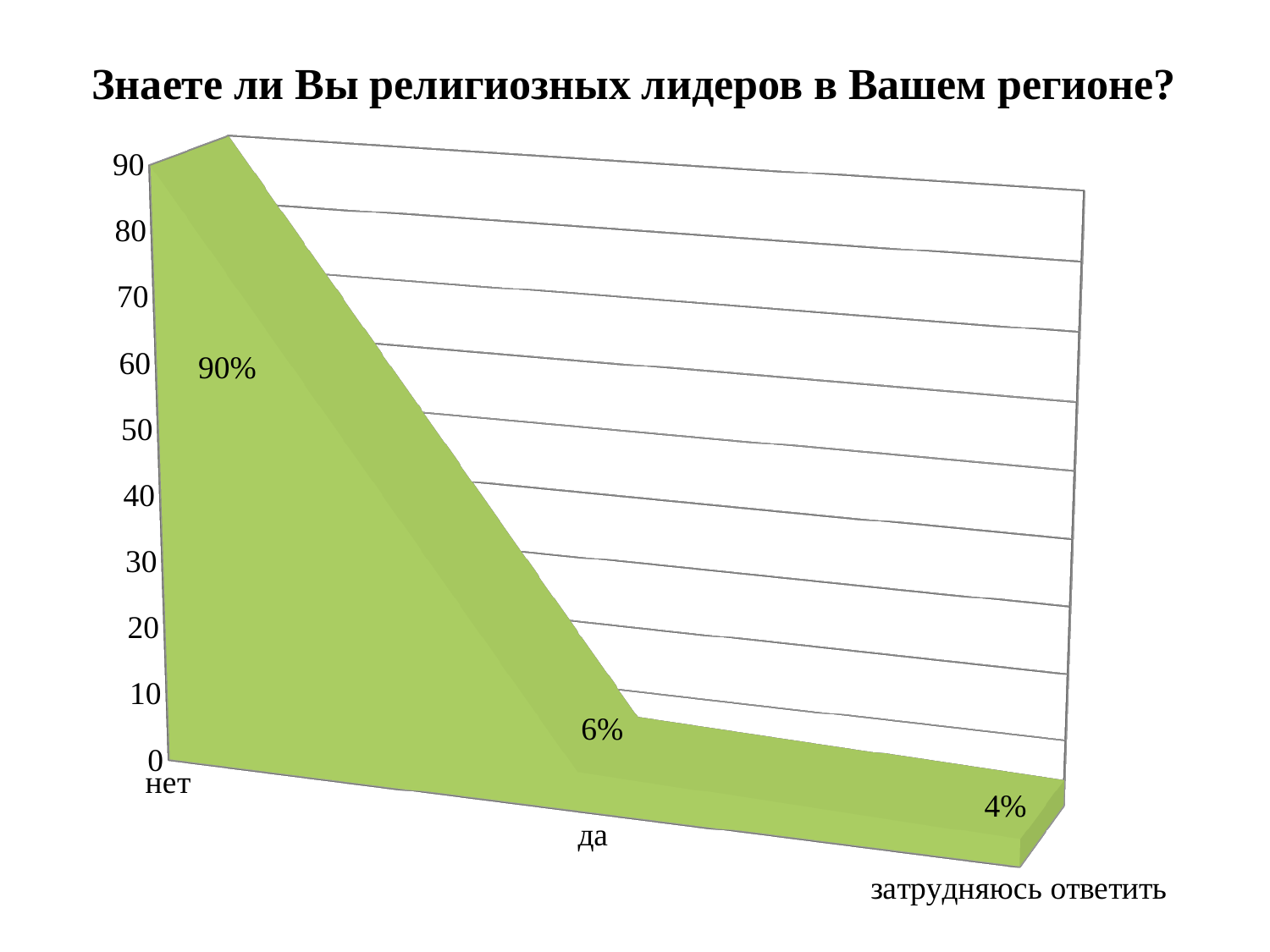
How many categories are shown on the x axis? 3 What is the value for "затрудняюсь ответить"? 4% Which category has the highest value? нет Is the value for "нет" greater or less than 50? greater What is the difference between the values for "да" and "затрудняюсь ответить"? 2% What kind of chart is shown on the slide? area chart What is the value for "да"? 6% What is the value for "нет"? 90% What is the difference between the values for "нет" and "да"? 84% What is the title of the chart? Знаете ли Вы религиозных лидеров в Вашем регионе? Which category has the lowest value? затрудняюсь ответить Which is larger, the value for "да" or the value for "затрудняюсь ответить"? да